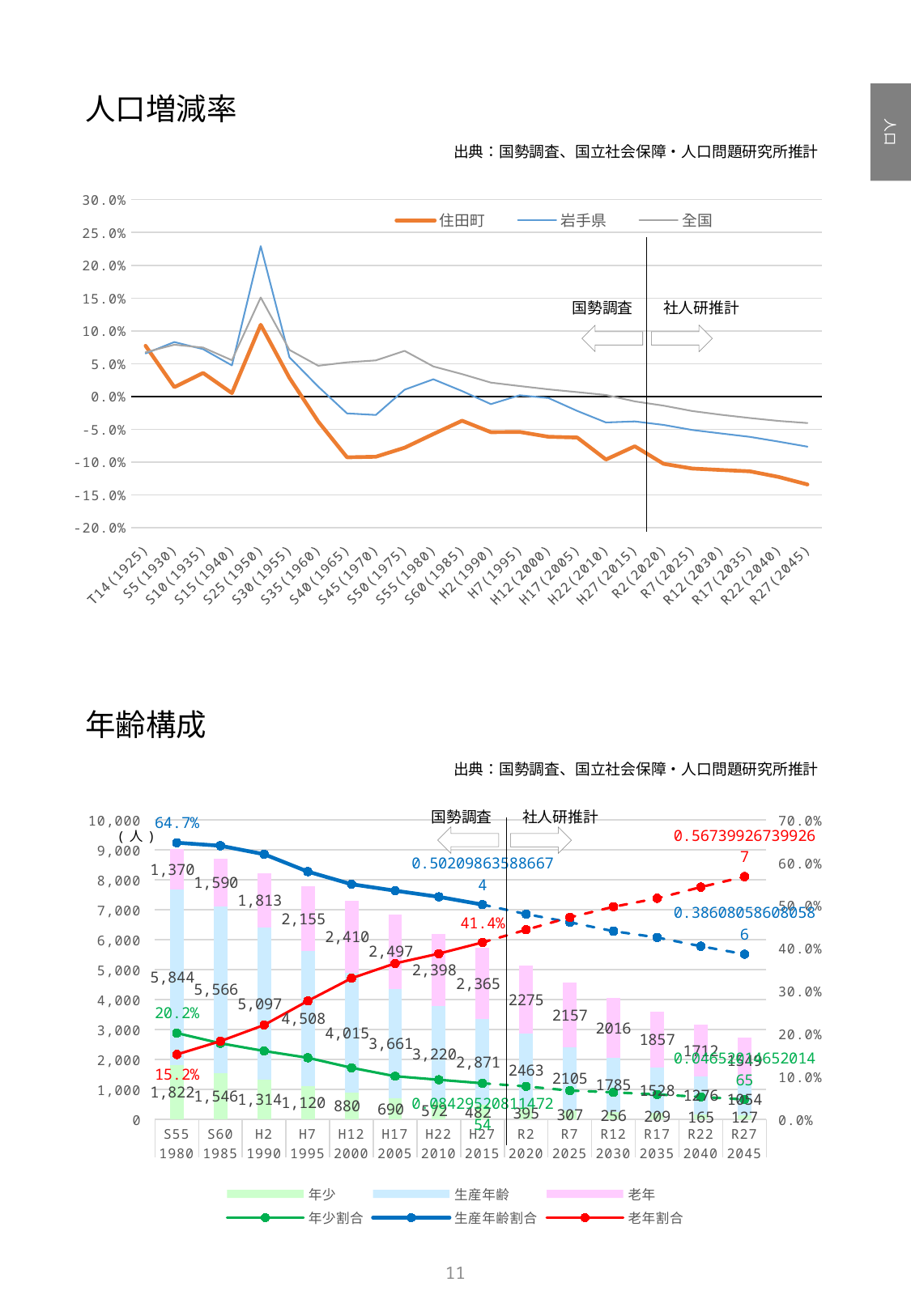
In the 年齢構成 chart at the bottom, what is the total of the stacked bar for S55 1980? 9,036 In the 年齢構成 chart at the bottom, what is the difference between the 生産年齢 value for S55 1980 and for R27 2045? 4,790 In the 年齢構成 chart at the bottom, what is the 老年 value for H12 2000? 2,410 In the 年齢構成 chart at the bottom, what is the 老年割合 value labelled at H27 2015? 41.4% In the 人口増減率 chart at the top, how many points are on the x axis? 24 In the 人口増減率 chart at the top, is the value for 岩手県 at S25(1950) greater or less than 20.0%? greater In the 人口増減率 chart at the top, how many series does the legend list? 3 In the 人口増減率 chart at the top, is the value for 住田町 at R27(2045) greater or less than -10.0%? less In the 人口増減率 chart at the top, which series has the highest value at S25(1950)? 岩手県 In the 人口増減率 chart at the top, what kind of chart is it? line chart In the 年齢構成 chart at the bottom, in which year is the 老年 value highest? H17 2005 In the 年齢構成 chart at the bottom, what is the 年少 value for R27 2045? 127